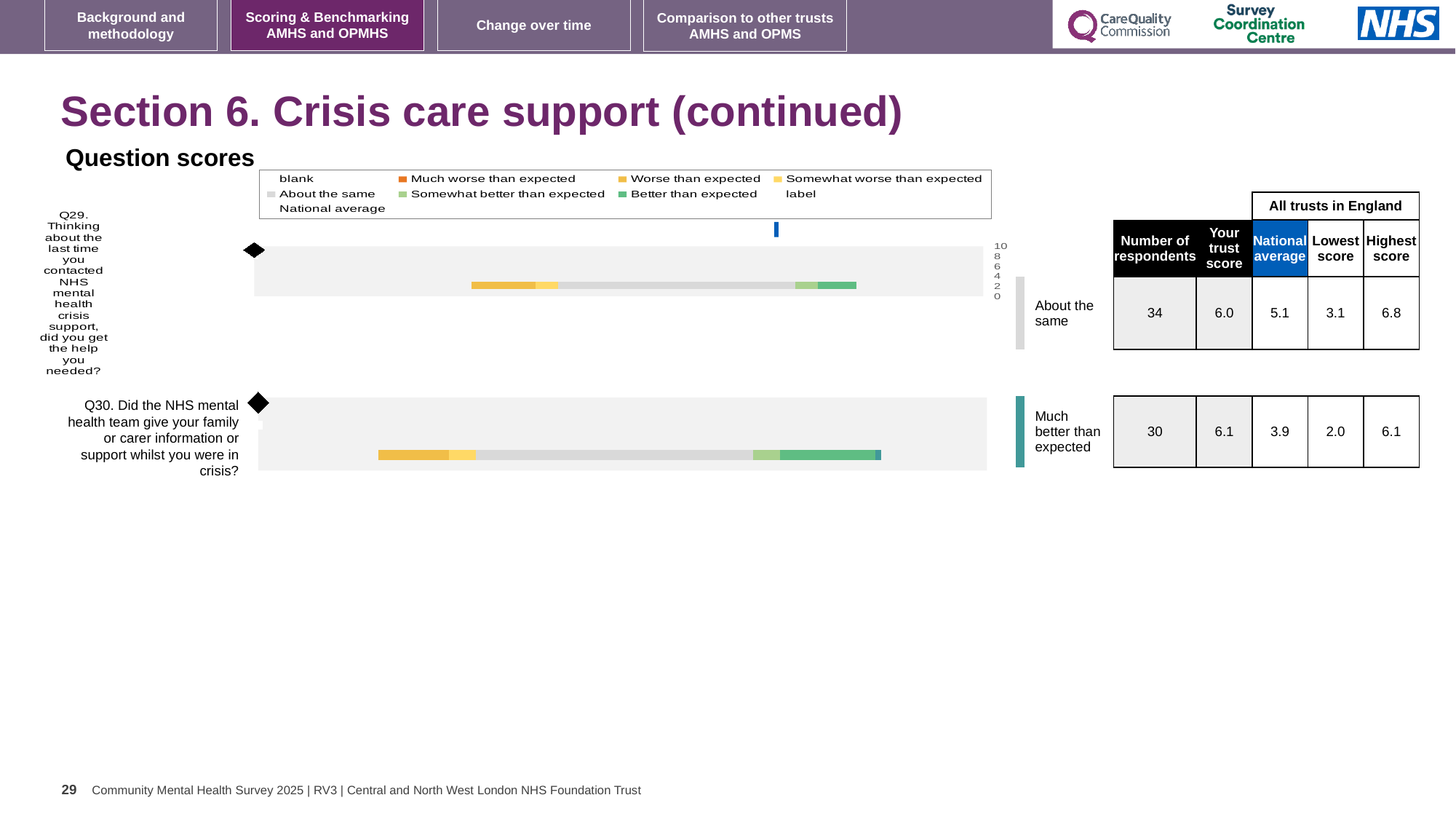
For Q29, which is larger: the trust score or the national average? trust score What is the difference between the trust score and the national average for Q30? 2.2 What is the trust score for Q29? 6.0 What kind of chart is used to show the question scores on this slide? bar chart How many questions are plotted in the Question scores chart? 2 In the chart legend, what colour represents 'About the same'? grey What is the national average for Q30? 3.9 What is the highest score across all trusts in England for Q29? 6.8 Which question has the higher number of respondents, Q29 or Q30? Q29 What is the title of the chart on this slide? Question scores How many respondents are shown for Q29? 34 What benchmark category is shown for Q30? Much better than expected